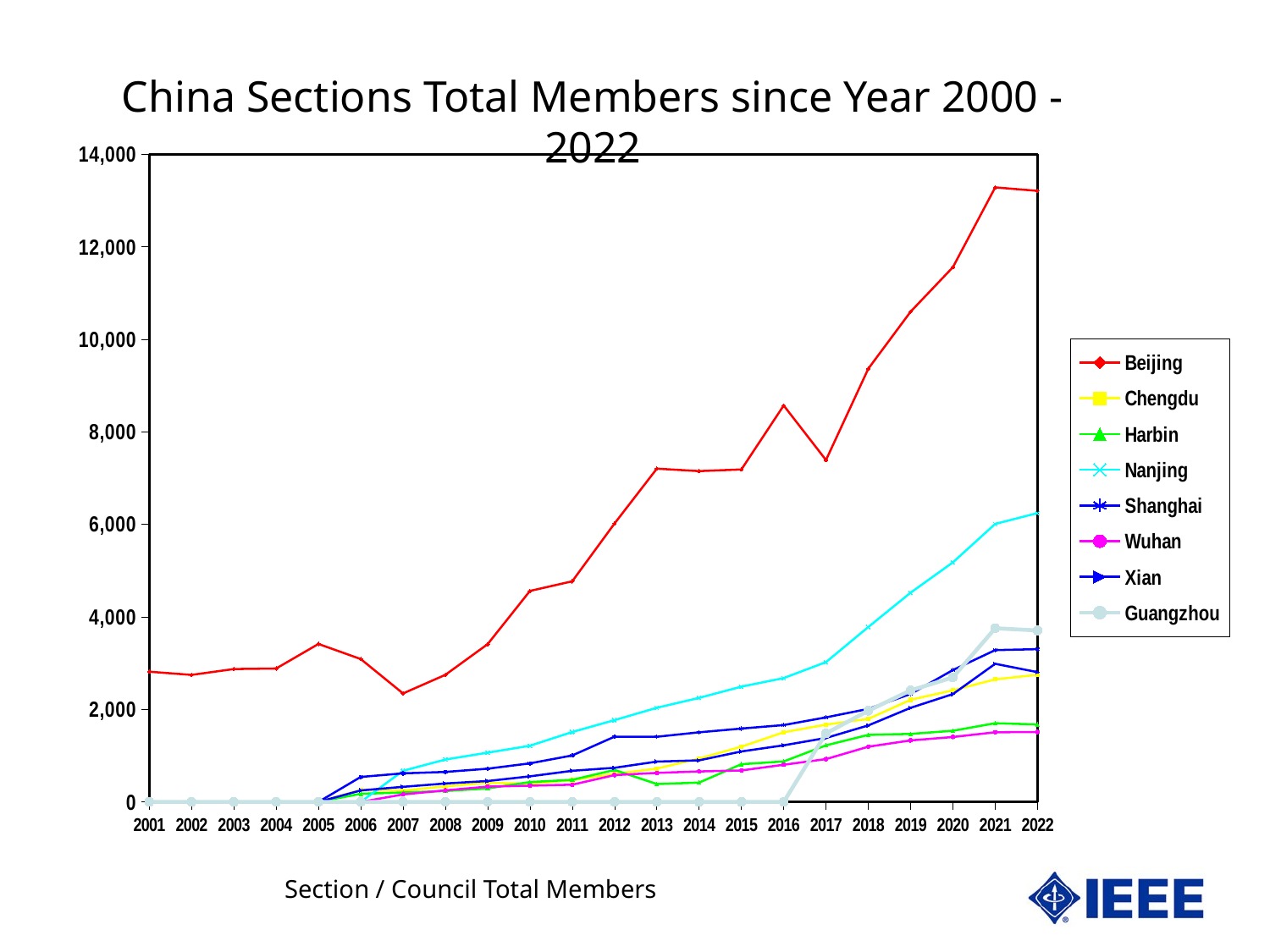
Is the value for Beijing in 2022 greater or less than 12,000? greater How many years are shown along the x axis? 22 Which section has the highest total members in 2022? Beijing Does the Beijing line generally rise or fall from 2001 to 2022? rise How many series does the legend list? 8 Is the value for Harbin in 2022 greater or less than 2,000? less What kind of chart is shown on the slide? line chart What is the title of the chart? China Sections Total Members since Year 2000 - 2022 Is the value for Nanjing in 2022 greater or less than 6,000? greater Which is larger in 2022, the value for Nanjing or the value for Shanghai? Nanjing What is the value for Guangzhou in 2010? 0